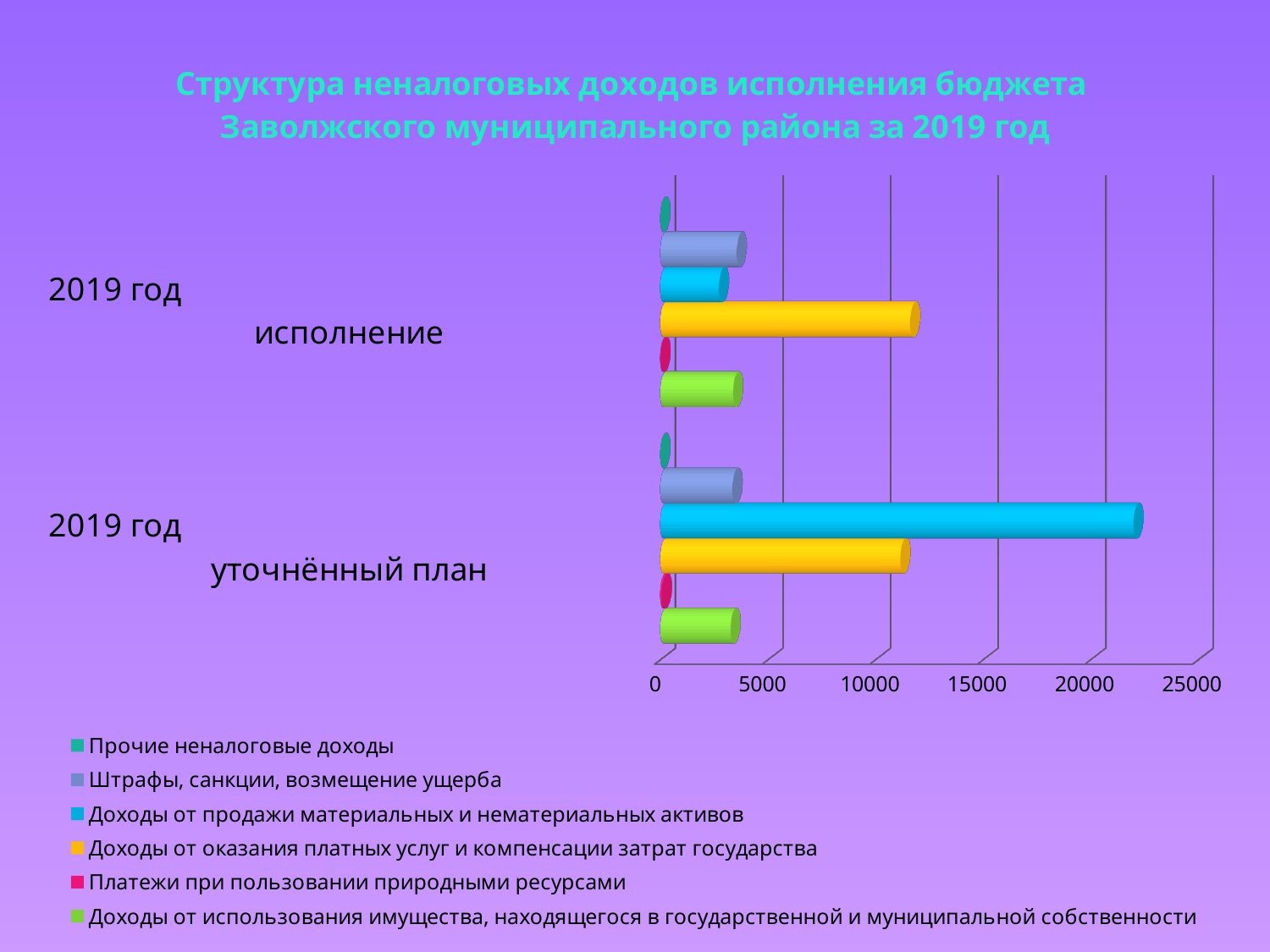
Is the value of "Доходы от продажи материальных и нематериальных активов" for "2019 год уточнённый план" greater or less than 20000? greater How many categories are shown on the vertical axis of the chart? 2 Is the value of "Доходы от оказания платных услуг и компенсации затрат государства" for "2019 год исполнение" greater or less than 10000? greater What kind of chart is shown on the slide? bar chart Is the value of "Штрафы, санкции, возмещение ущерба" for "2019 год уточнённый план" greater or less than 5000? less Which series is shown in yellow in the legend? Доходы от оказания платных услуг и компенсации затрат государства Which series has the longest bar for "2019 год уточнённый план"? Доходы от продажи материальных и нематериальных активов What is the title of the chart? Структура неналоговых доходов исполнения бюджета Заволжского муниципального района за 2019 год For "Доходы от продажи материальных и нематериальных активов", which category has the larger value: "2019 год исполнение" or "2019 год уточнённый план"? 2019 год уточнённый план How many series does the legend list? 6 Which series has the longest bar for "2019 год исполнение"? Доходы от оказания платных услуг и компенсации затрат государства